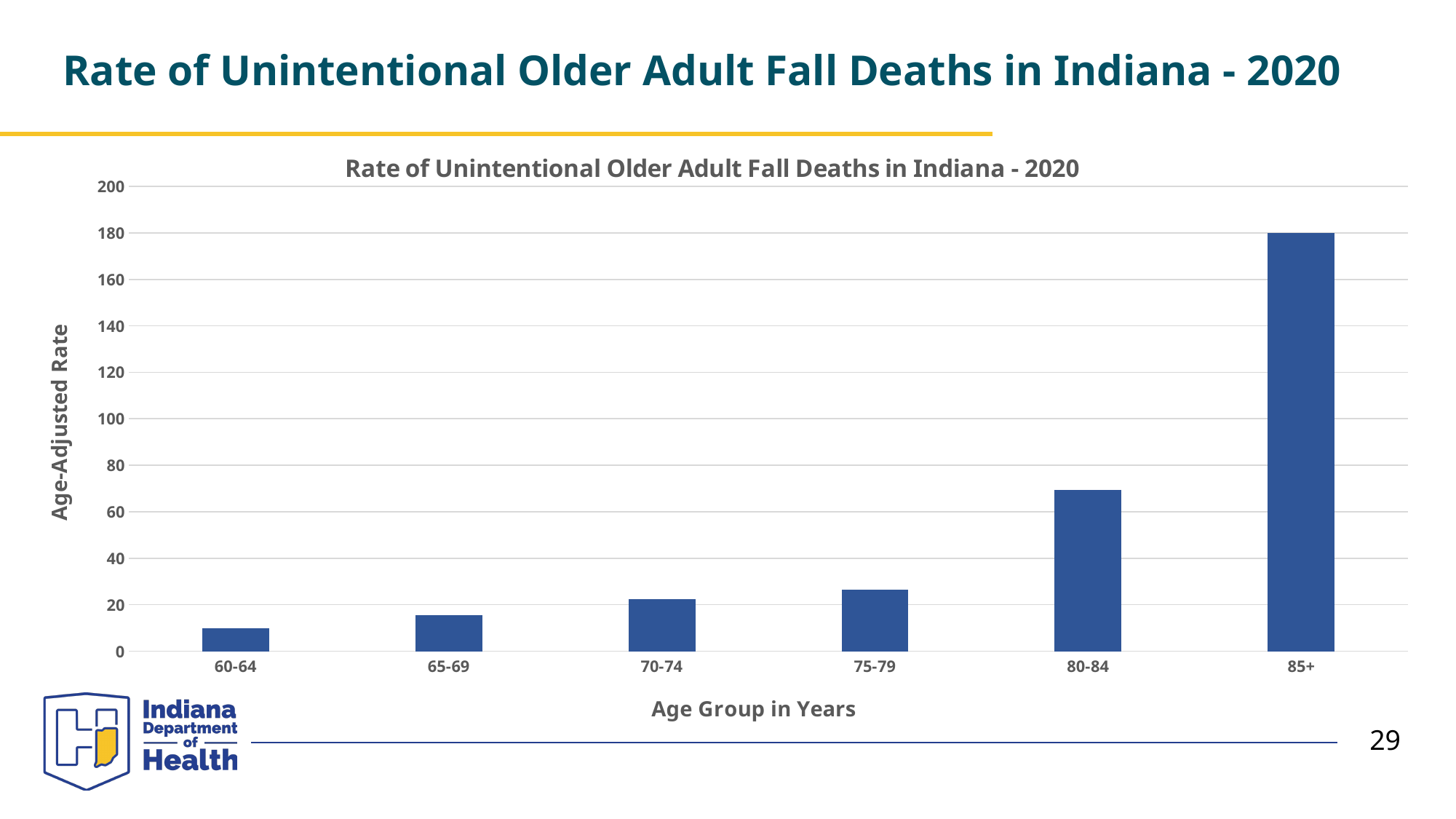
Which has a larger age-adjusted rate, the 70-74 age group or the 80-84 age group? 80-84 Is the value for the 60-64 age group greater or less than 20? less Is the value for the 85+ age group greater or less than 160? greater What kind of chart is shown on the slide? bar chart Which age group has the highest age-adjusted rate? 85+ How many age groups are shown on the x axis? 6 Is the value for the 80-84 age group greater or less than 60? greater Do the age-adjusted rates rise or fall as the age groups increase along the x axis? rise What is the label of the y axis? Age-Adjusted Rate Which age group has the lowest age-adjusted rate? 60-64